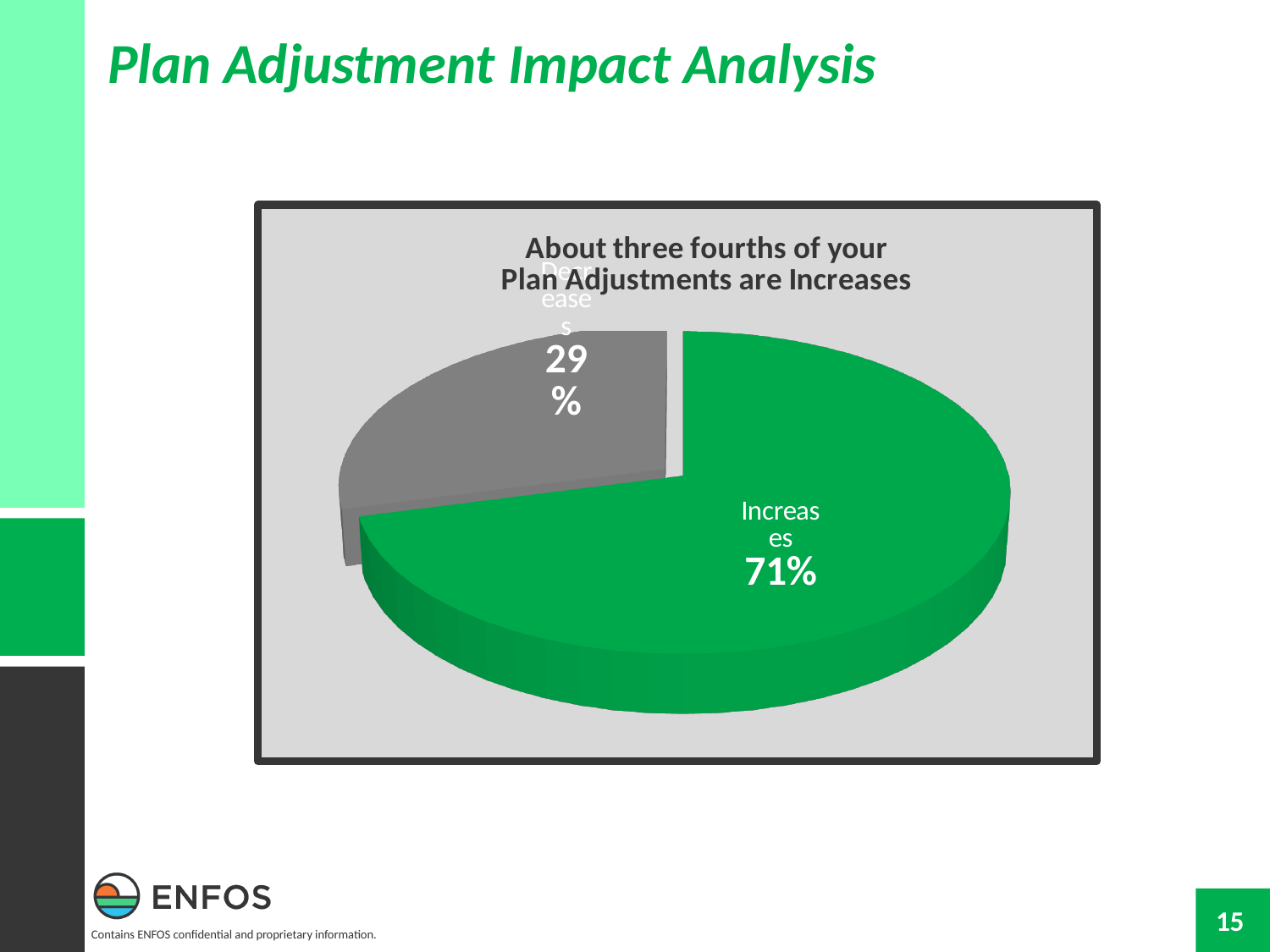
What is the title of the chart? About three fourths of your Plan Adjustments are Increases What colour is the Increases slice? Green What percentage of plan adjustments are Increases? 71% Which slice of the pie is the smallest? Decreases What share of the pie does the Increases slice represent? 71% Which is larger, the Increases slice or the Decreases slice? Increases Which slice of the pie is the largest? Increases What percentage of plan adjustments are Decreases? 29% How many slices does the pie chart have? 2 What kind of chart is shown on the slide? Pie chart What is the difference in percentage points between the Increases and Decreases slices? 42